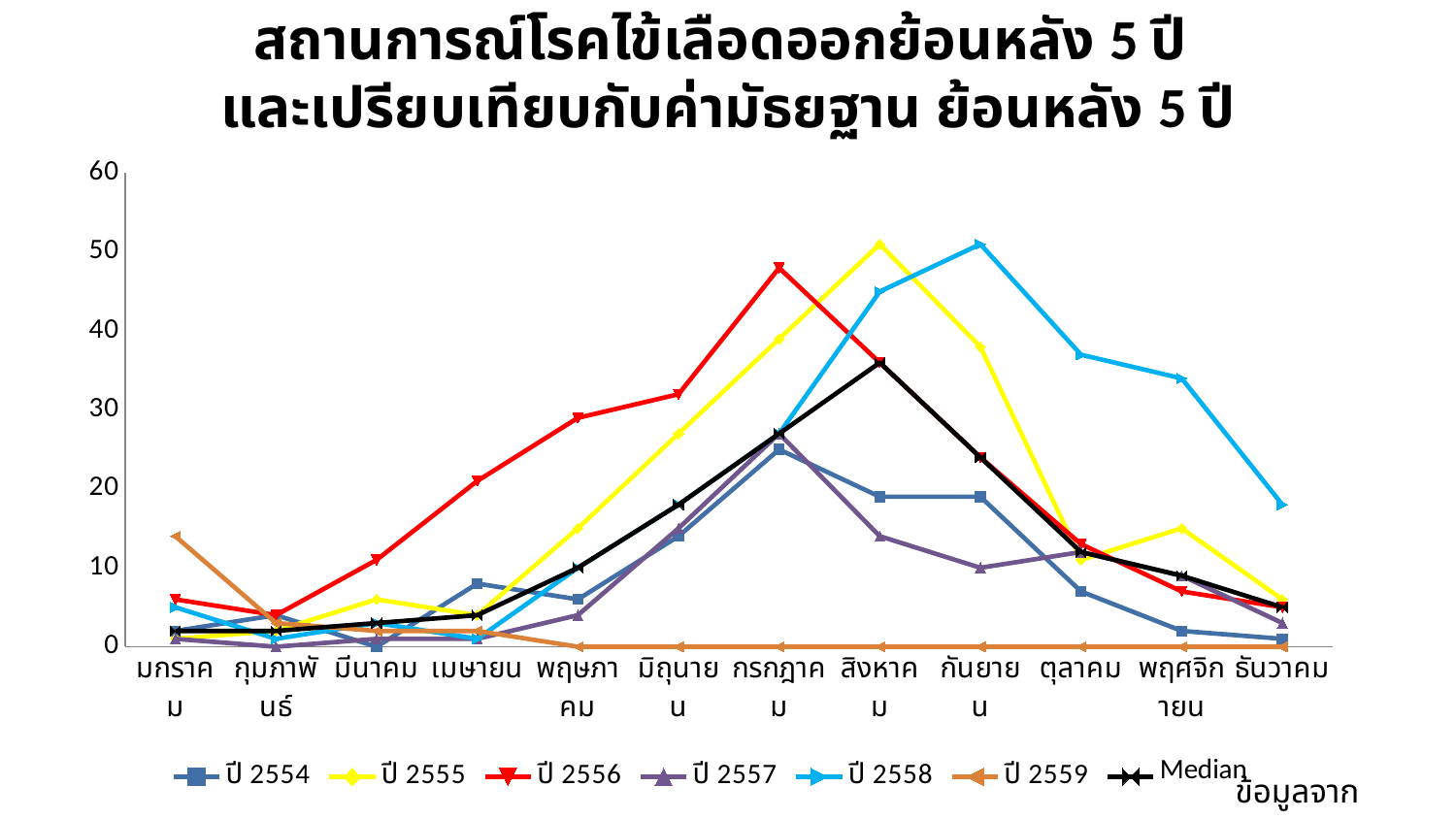
In กันยายน, which series has the larger value, ปี 2558 or ปี 2555? ปี 2558 Is the value for ปี 2556 in กรกฎาคม greater or less than 40? greater Is the value for Median in สิงหาคม greater or less than 30? greater Does the ปี 2558 series rise or fall from กันยายน to ธันวาคม? fall How many months are shown along the x axis? 12 What is the last entry listed in the legend? Median How many series does the legend list? 7 Is the value for ปี 2558 in ธันวาคม greater or less than 10? greater In which month does the ปี 2556 series reach its highest value? กรกฎาคม What kind of chart is shown on the slide? line chart In which month does the Median series reach its highest value? สิงหาคม In which month does the ปี 2558 series reach its highest value? กันยายน